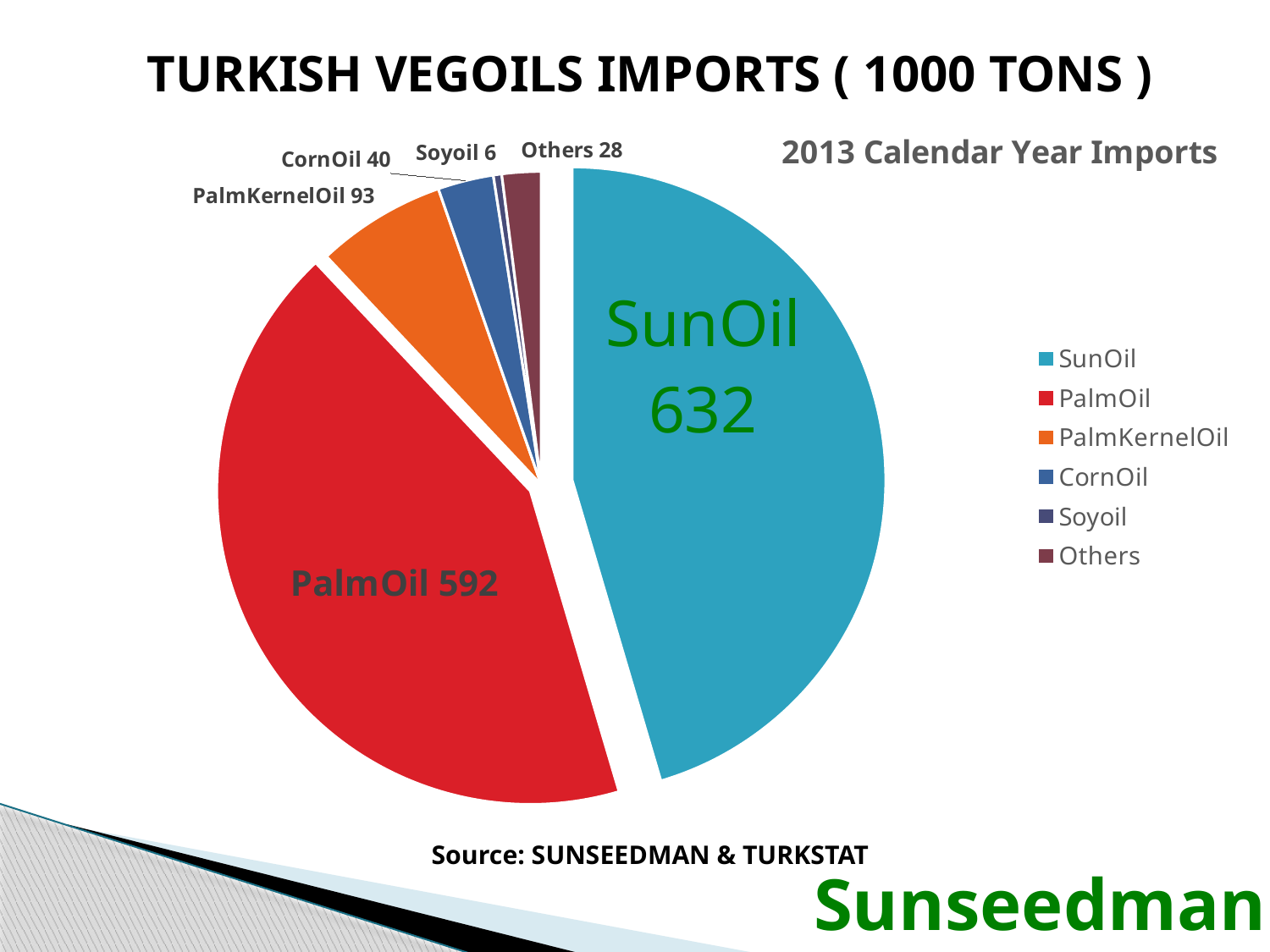
Which is larger, the value for PalmKernelOil or the value for Others? PalmKernelOil How many categories does the legend of the pie chart list? 6 What is the value for CornOil in the pie chart? 40 What is the value for SunOil in the pie chart? 632 What is the value for PalmKernelOil in the pie chart? 93 What type of chart is shown on the slide? pie chart What is the value for Soyoil in the pie chart? 6 What is the value for PalmOil in the pie chart? 592 What is the title of the chart on the slide? 2013 Calendar Year Imports Which category has the smallest slice in the pie chart? Soyoil What is the difference between the SunOil and PalmOil values? 40 Which category has the largest slice in the pie chart? SunOil